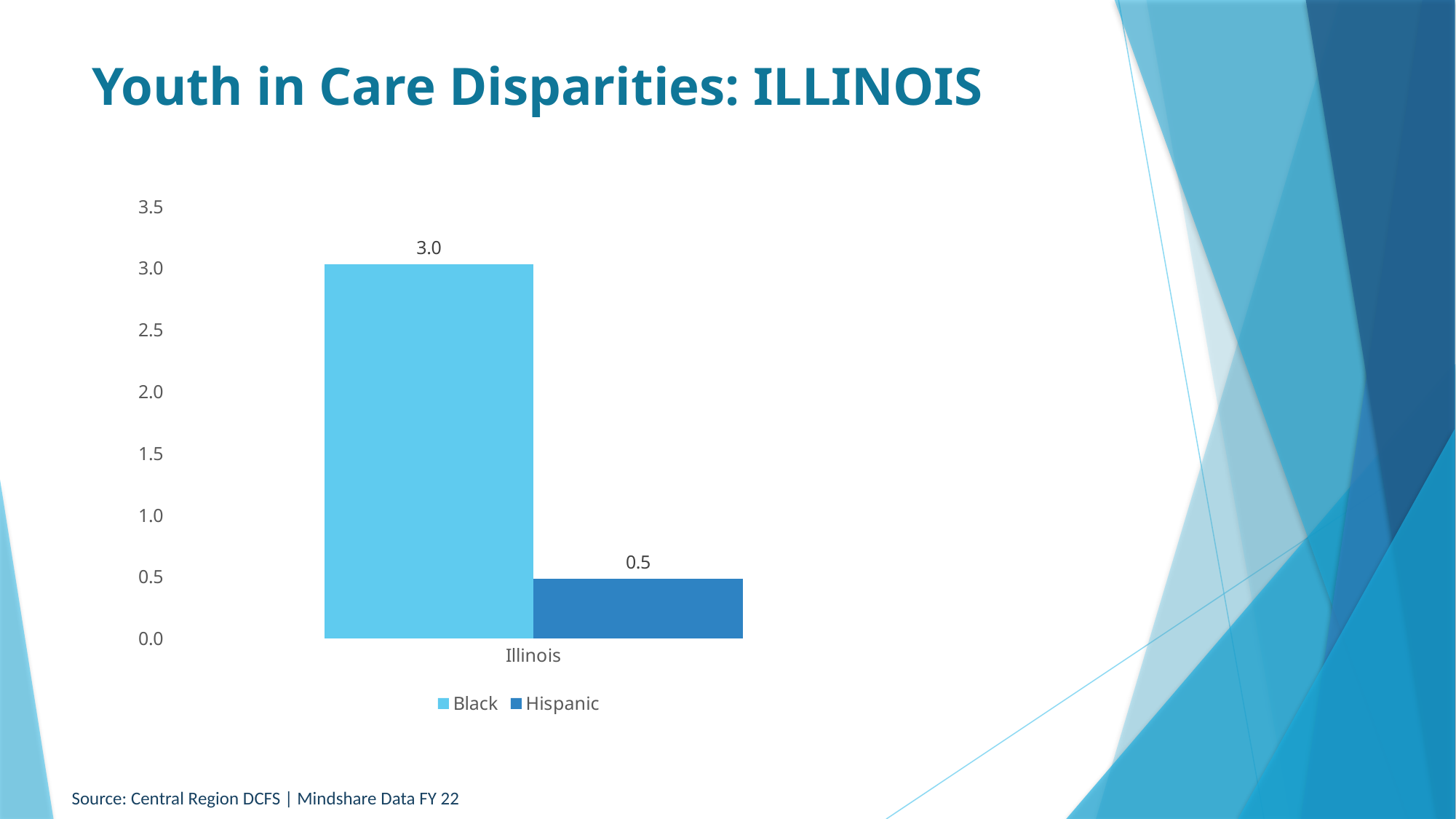
What is the difference between the Black and Hispanic values for Illinois? 2.5 What is the highest value shown on the y axis? 3.5 How many series does the legend list? 2 Which series has the lowest value on the chart? Hispanic Is the value for Black greater or less than 2.0? greater What is the value for Black in Illinois? 3.0 Which series has the higher value for Illinois, Black or Hispanic? Black What is the title of the slide? Youth in Care Disparities: ILLINOIS How many categories are shown on the x axis? 1 Is the value for Hispanic greater or less than 1.0? less What is the value for Hispanic in Illinois? 0.5 What kind of chart is shown on the slide? Bar chart